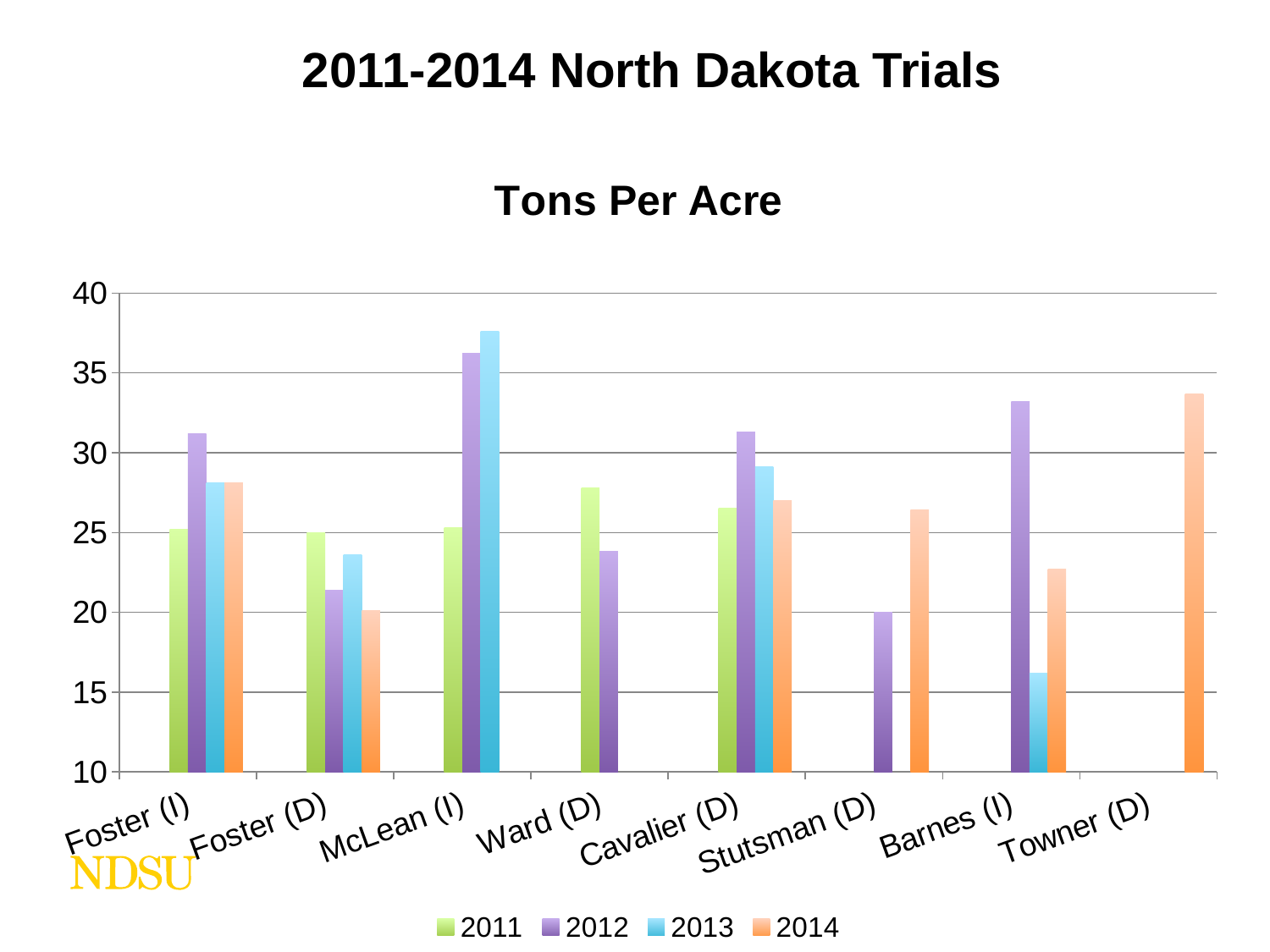
Which category has the highest value for 2013? McLean (I) What is the title of the chart? Tons Per Acre Which category has the lowest value for 2013? Barnes (I) How many series does the legend list? 4 For Barnes (I), which is larger: the 2012 value or the 2014 value? 2012 How many categories are shown on the x axis? 8 Which category has the highest value for 2012? McLean (I) Is the 2013 value for Barnes (I) greater or less than 20? less What kind of chart is shown on the slide? bar chart Is the 2014 value for Towner (D) greater or less than 30? greater For Foster (D), which is larger: the 2011 value or the 2014 value? 2011 Is the 2012 value for Foster (I) greater or less than 30? greater